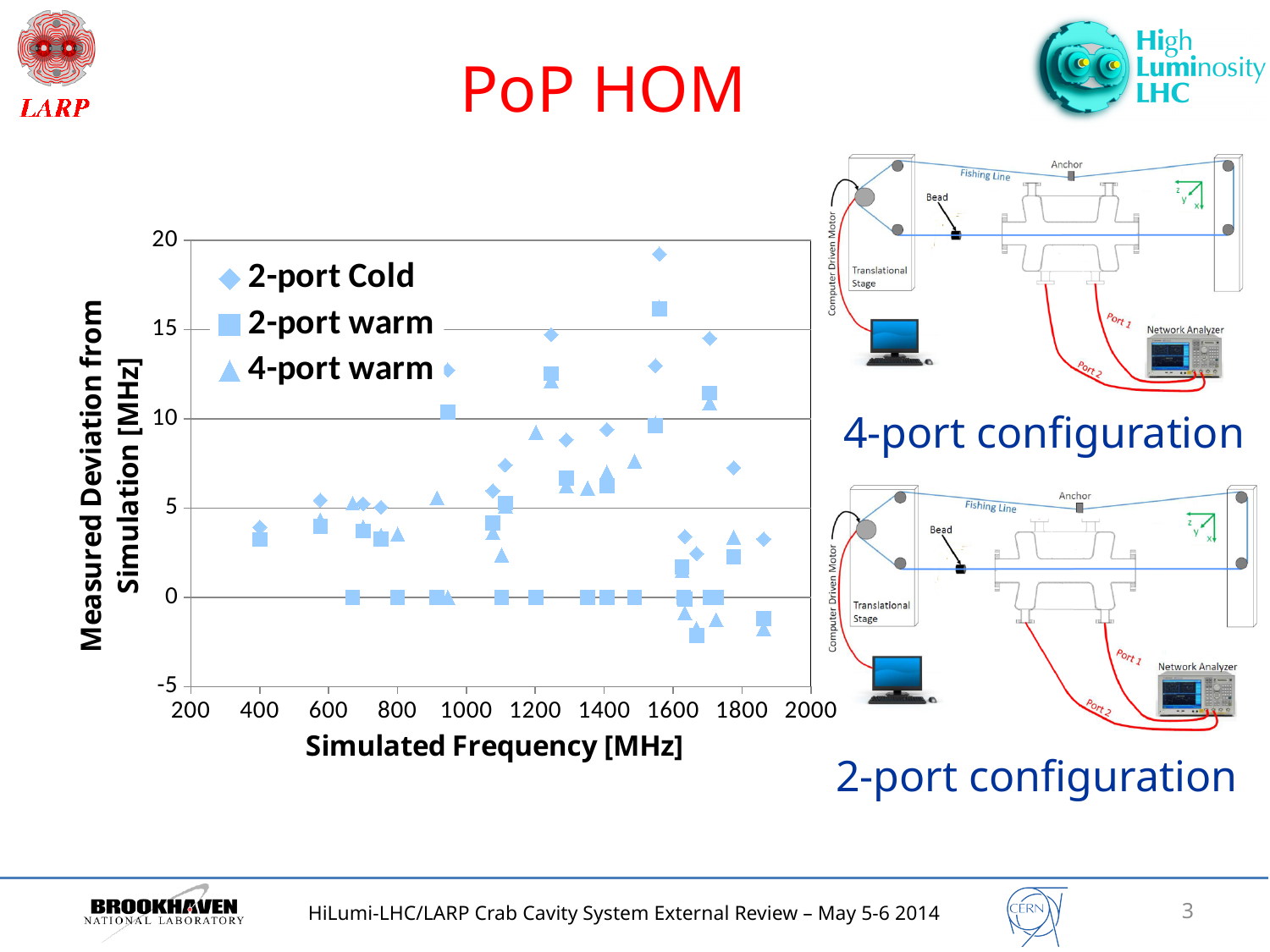
Which series contains the highest plotted point on the chart? 2-port Cold What kind of chart is shown on the slide? scatter chart Is the 2-port Cold point near 1860 MHz greater or less than 5? less Is the 2-port warm point near 1560 MHz greater or less than 15? greater What are the three series named in the chart's legend? 2-port Cold, 2-port warm, 4-port warm How many series does the chart's legend list? 3 Is the 2-port Cold point near 1250 MHz greater or less than 10? greater What is the title of the chart's x axis? Simulated Frequency [MHz]